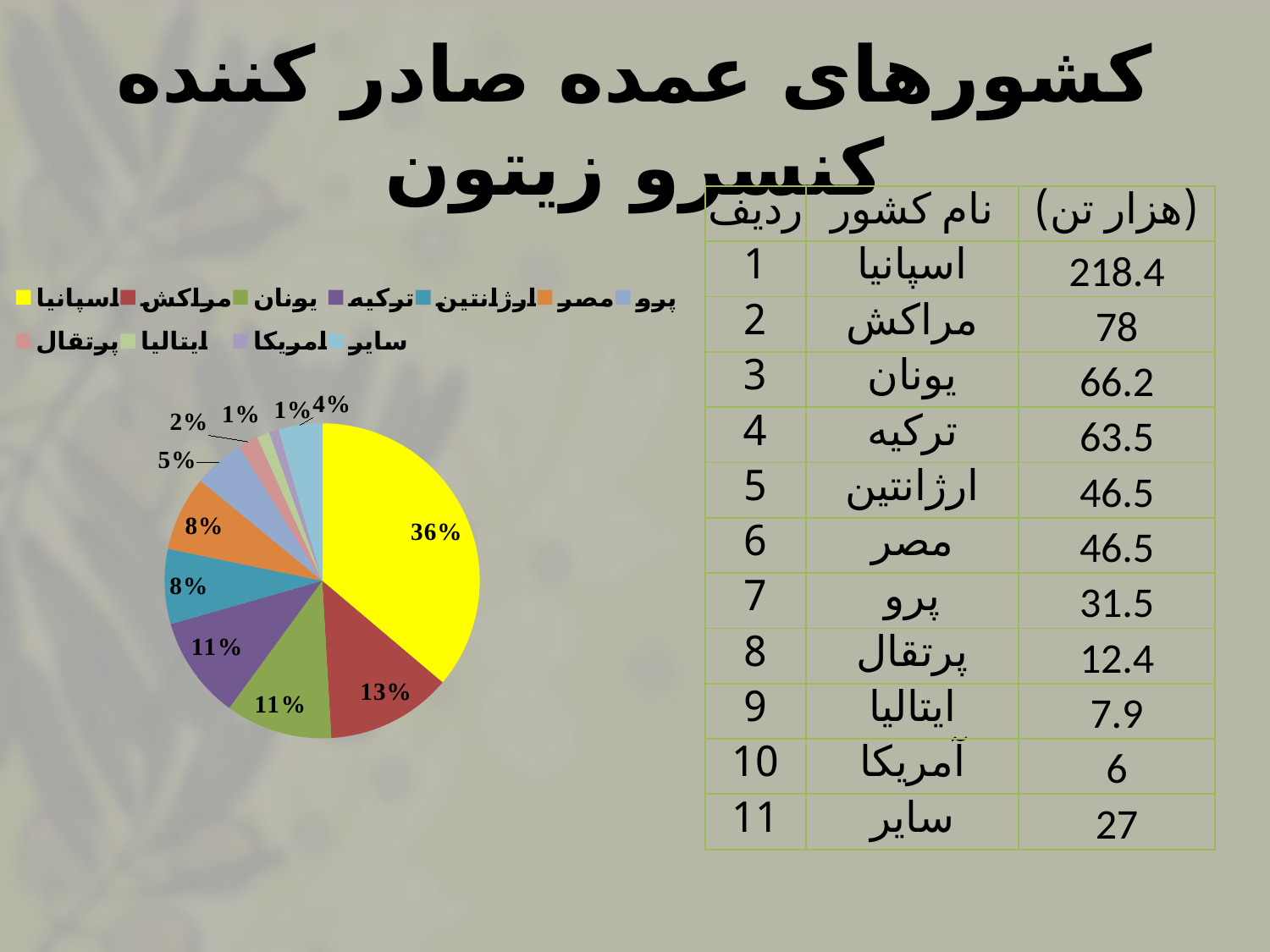
Which country has the largest slice of the pie? اسپانیا (Spain) What share of the pie does سایر (Other) hold? 4% What colour is the slice for اسپانیا (Spain)? yellow What share of the pie does پرتقال (Portugal) hold? 2% How many entries does the legend list? 11 By how many percentage points does the اسپانیا (Spain) slice exceed the مراکش (Morocco) slice? 23 percentage points What share of the pie does اسپانیا (Spain) hold? 36% Which slice is larger, اسپانیا (Spain) or مراکش (Morocco)? اسپانیا (Spain) What kind of chart is shown on the slide? pie chart How many slices does the pie chart have? 11